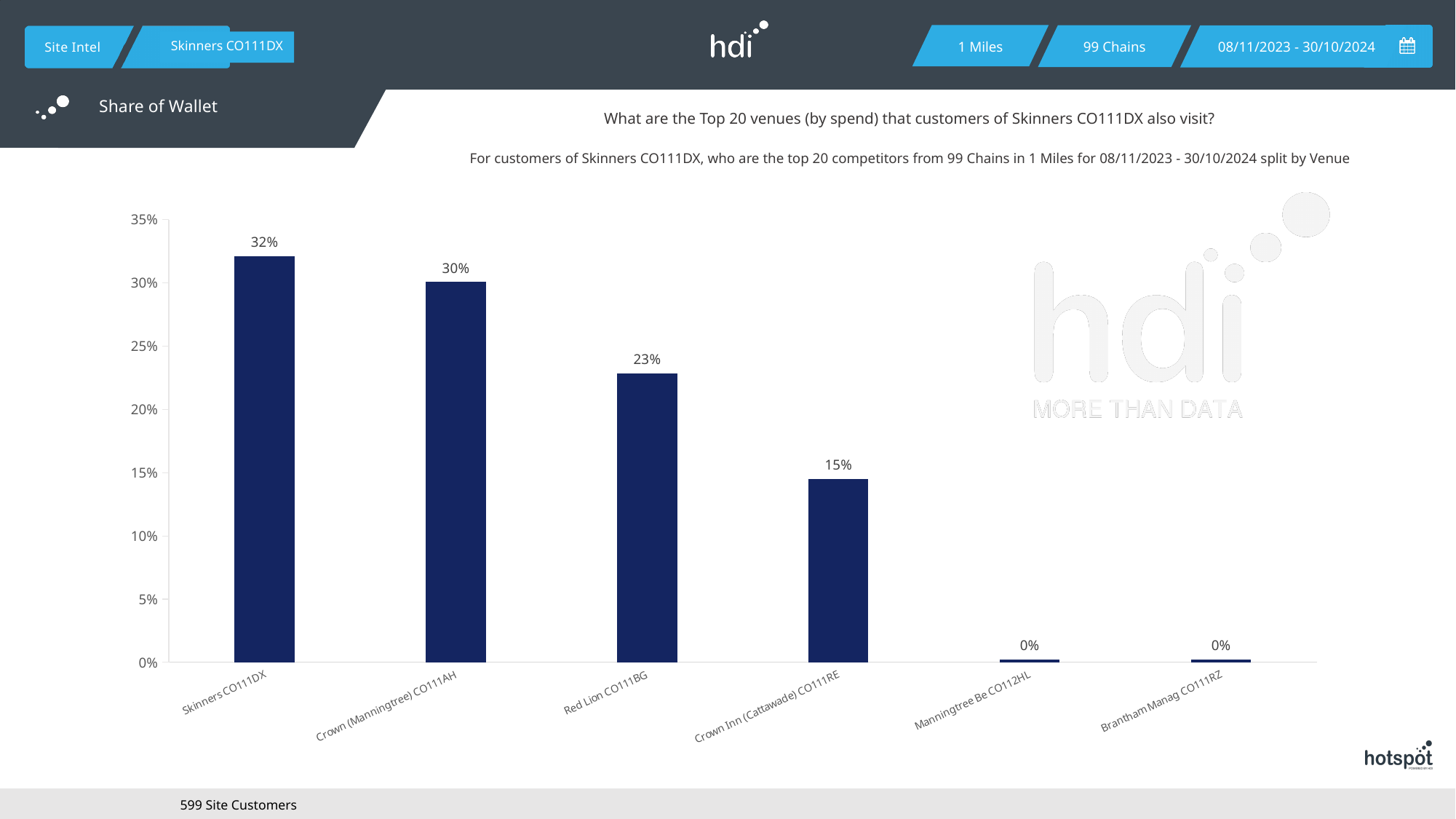
Which is larger, the value for Red Lion CO111BG or Crown Inn (Cattawade) CO111RE? Red Lion CO111BG Which venue has the highest value? Skinners CO111DX What is the difference between the values for Crown (Manningtree) CO111AH and Crown Inn (Cattawade) CO111RE? 15% How many venues are shown on the chart? 6 What is the value for Manningtree Be CO112HL? 0% Do the values rise or fall from left to right along the x axis? Fall What kind of chart is shown on the slide? Bar chart What is the value for Crown (Manningtree) CO111AH? 30% What is the value for Skinners CO111DX? 32% What is the value for Red Lion CO111BG? 23% What is the difference between the values for Skinners CO111DX and Red Lion CO111BG? 9% What is the value for Crown Inn (Cattawade) CO111RE? 15%